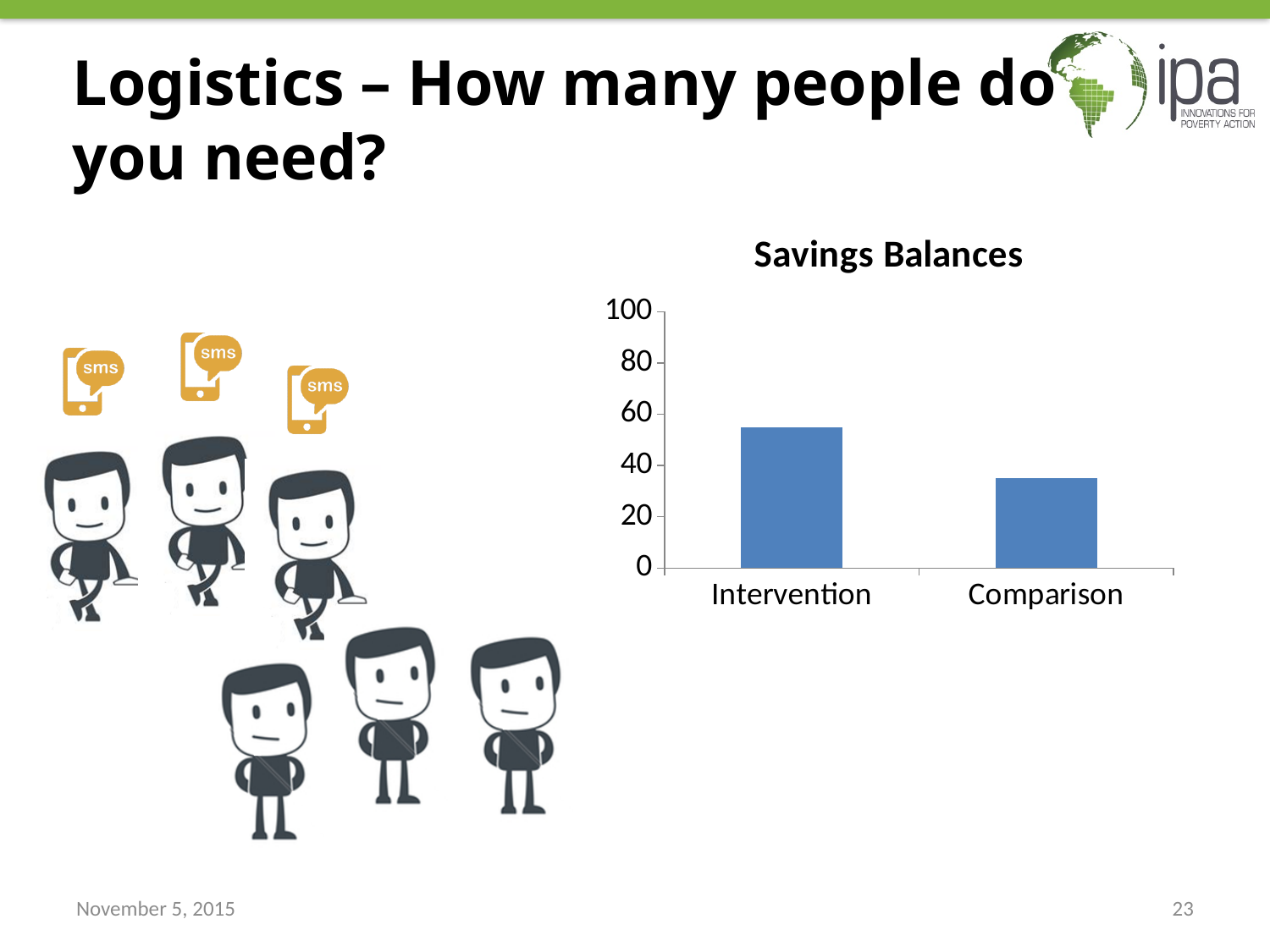
Do the values rise or fall from Intervention to Comparison? fall Which category has the highest savings balance? Intervention Which category has the lowest savings balance? Comparison What is the title of the chart? Savings Balances How many categories are plotted in the Savings Balances chart? 2 Which is larger, the value for Intervention or the value for Comparison? Intervention Is the value for Intervention greater or less than 60? less What kind of chart is shown on the slide? bar chart Is the value for Comparison greater or less than 40? less What is the highest value shown on the vertical axis of the chart? 100 Is the value for Comparison greater or less than 20? greater